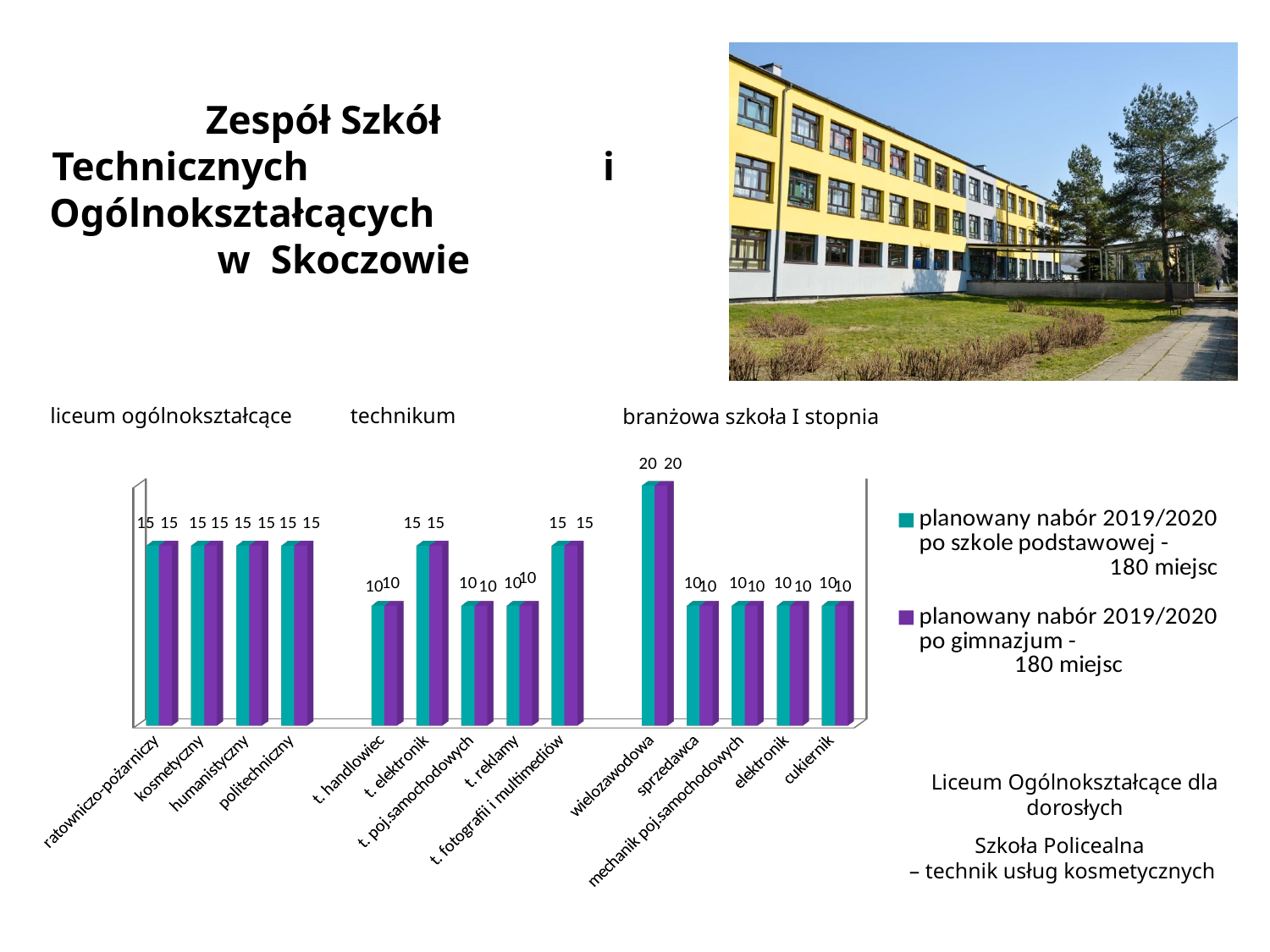
How many categories are shown on the x axis of the chart? 14 What is the planned intake after gimnazjum for t. fotografii i multimediów? 15 What kind of chart is shown on the slide? bar chart What is the planned intake after gimnazjum for t. handlowiec? 10 Which colour represents the series 'planowany nabór 2019/2020 po gimnazjum'? purple What is the total of the two series for sprzedawca? 20 How many series does the legend list? 2 What is the planned intake after primary school (po szkole podstawowej) for wielozawodowa? 20 Which category has the highest planned intake after primary school? wielozawodowa What is the planned intake after primary school for kosmetyczny? 15 What is the difference between the planned intake after primary school for wielozawodowa and for cukiernik? 10 Which is larger: the planned intake after gimnazjum for t. elektronik or for t. reklamy? t. elektronik